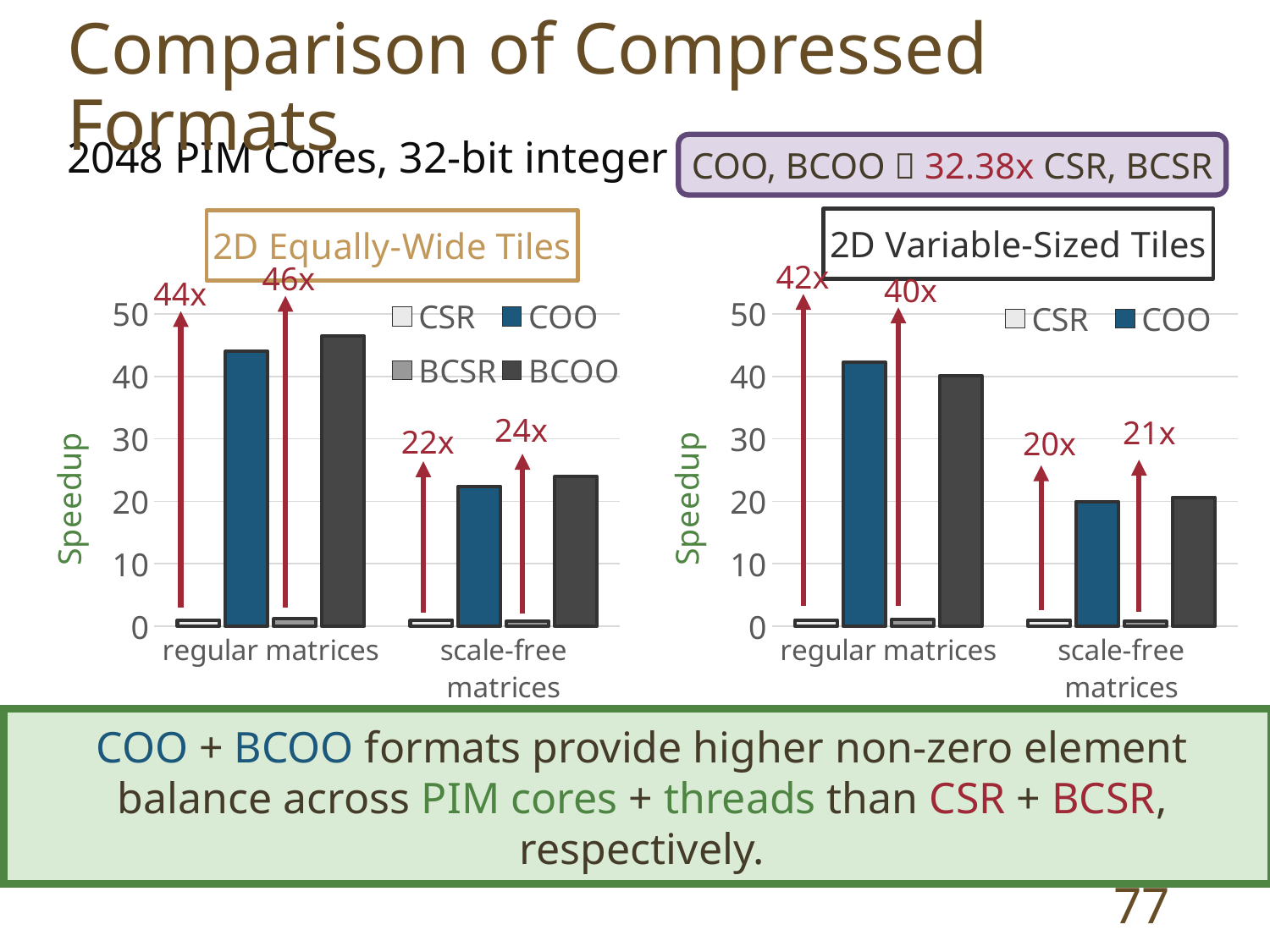
In the 2D Equally-Wide Tiles chart, does the COO speedup rise or fall from regular matrices to scale-free matrices? fall In the 2D Equally-Wide Tiles chart, is the COO speedup larger for regular matrices or for scale-free matrices? regular matrices In the 2D Equally-Wide Tiles chart, is the BCOO speedup for scale-free matrices greater or less than 30? less What kind of chart is the 2D Equally-Wide Tiles chart? bar chart In the 2D Variable-Sized Tiles chart, is the COO speedup for regular matrices greater or less than 30? greater What is the title of the chart on the right side of the slide? 2D Variable-Sized Tiles How many series does the legend of the 2D Equally-Wide Tiles chart list? 4 In the 2D Variable-Sized Tiles chart, which has the larger speedup for regular matrices, CSR or COO? COO How many categories are shown on the x axis of the 2D Equally-Wide Tiles chart? 2 In the 2D Equally-Wide Tiles chart, is the COO speedup for regular matrices greater or less than 40? greater What ratio is annotated above the COO bar for regular matrices in the 2D Equally-Wide Tiles chart? 44x